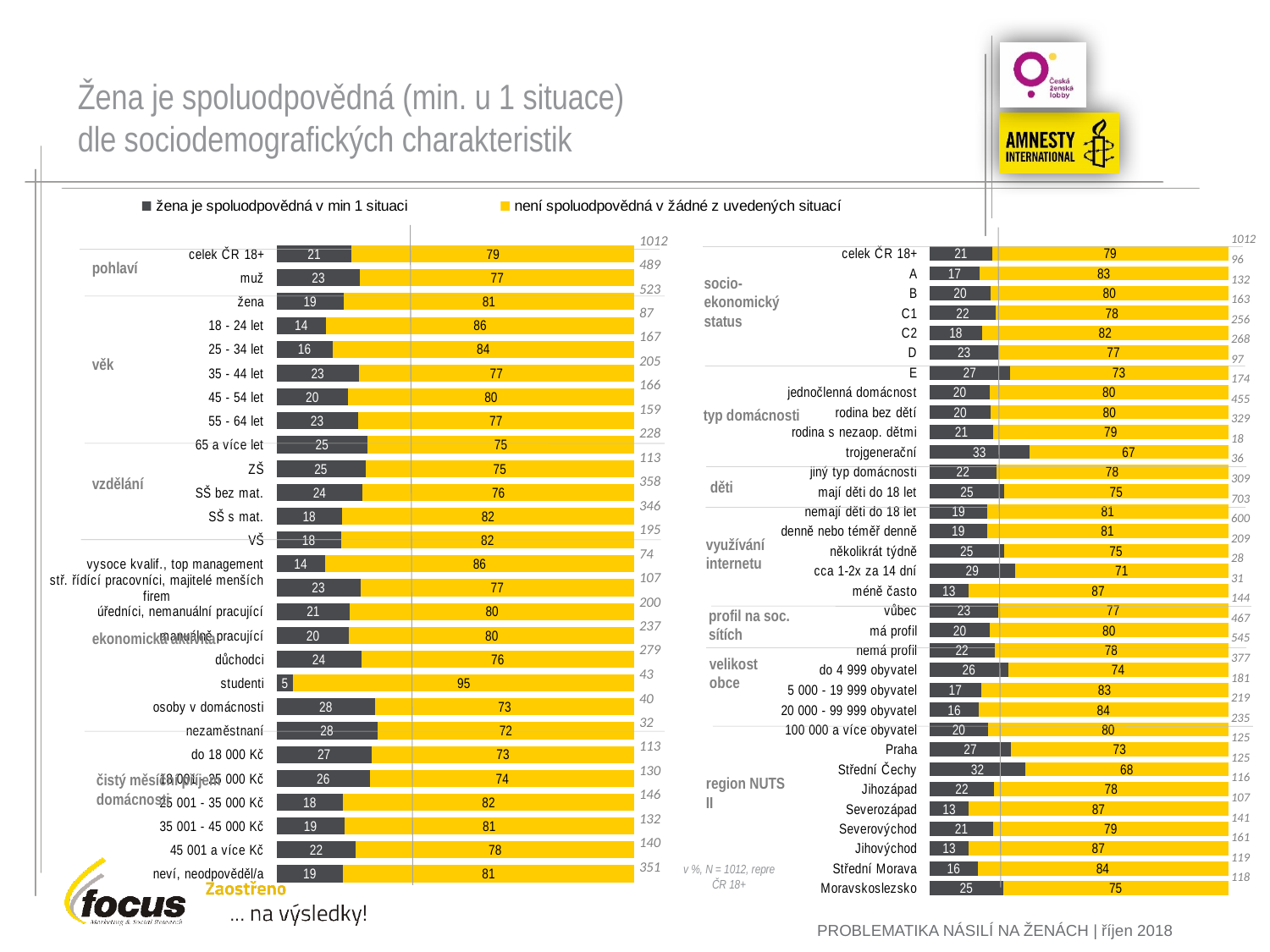
On the right chart, what is the value of 'není spoluodpovědná v žádné z uvedených situací' for 'Severozápad'? 87 On the left chart, which category has the lowest value for 'žena je spoluodpovědná v min 1 situaci'? studenti On the right chart, which category has the highest value for 'žena je spoluodpovědná v min 1 situaci'? trojgenerační How many series does the legend list? 2 Which colour represents 'není spoluodpovědná v žádné z uvedených situací' in the legend? Yellow On the right chart, which has a larger value for 'žena je spoluodpovědná v min 1 situaci': 'Praha' or 'Jihovýchod'? Praha On the right chart, what is the total of the stacked bar for 'Střední Čechy'? 100 On the left chart, what is the value of 'není spoluodpovědná v žádné z uvedených situací' for '18 - 24 let'? 86 On the left chart, what is the value of 'žena je spoluodpovědná v min 1 situaci' for 'studenti'? 5 On the right chart, what is the value of 'žena je spoluodpovědná v min 1 situaci' for 'trojgenerační'? 33 On the left chart, what is the difference between the 'není spoluodpovědná v žádné z uvedených situací' values for 'studenti' and 'nezaměstnaní'? 23 What type of chart is shown on the left side of the slide? Stacked bar chart